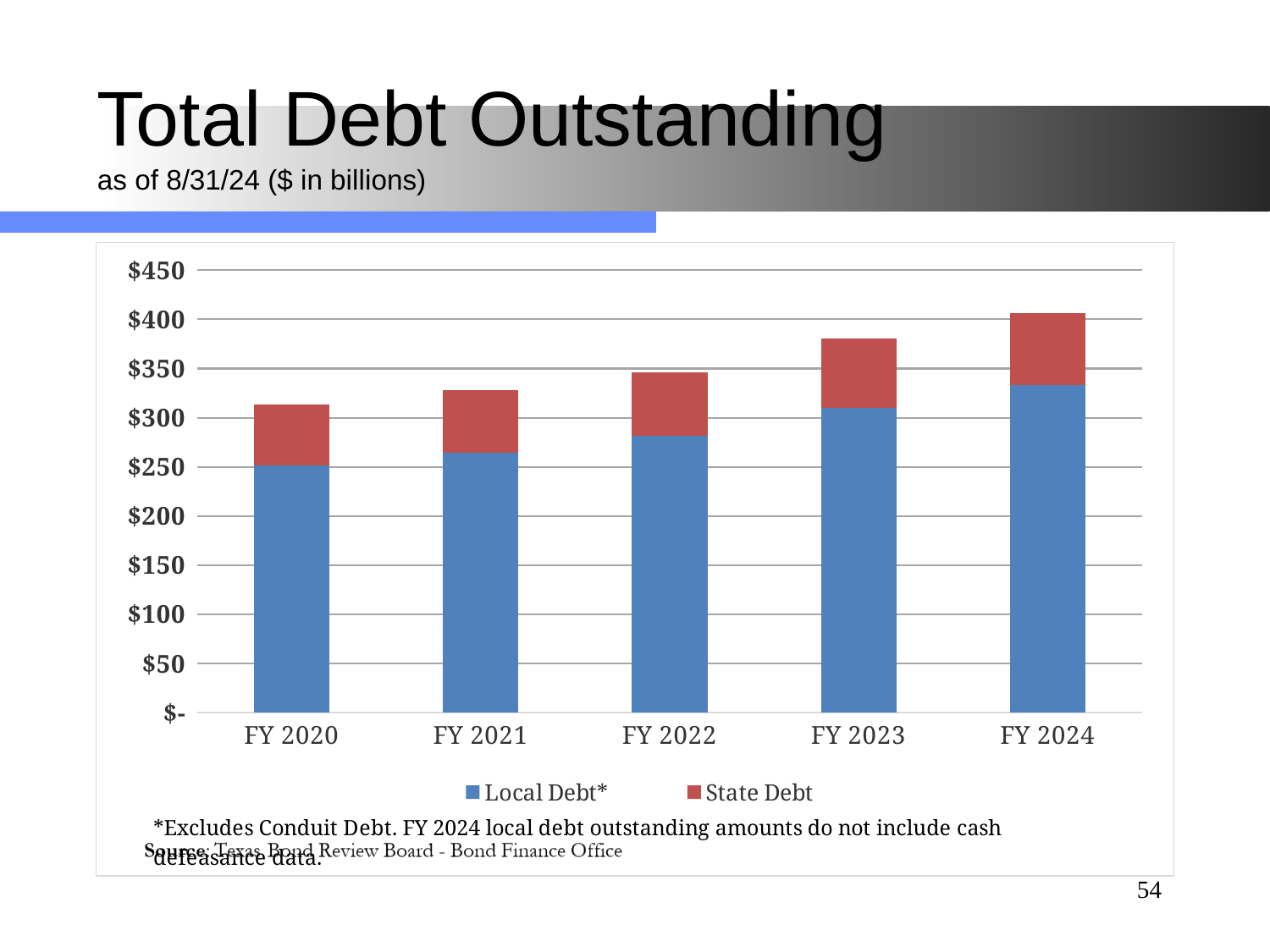
How many fiscal years are shown on the x axis? 5 What kind of chart is shown on the slide? Stacked bar chart Is the Local Debt* value for FY 2022 greater or less than $300? less Which series is shown in red in the chart? State Debt Which is larger, the total debt outstanding for FY 2023 or for FY 2021? FY 2023 Is the total debt outstanding for FY 2020 greater or less than $300? greater Is the total debt outstanding for FY 2021 greater or less than $350? less Does total debt outstanding rise or fall from FY 2020 to FY 2024? Rise Which fiscal year has the lowest total debt outstanding? FY 2020 Which fiscal year has the highest total debt outstanding? FY 2024 How many series does the legend list? 2